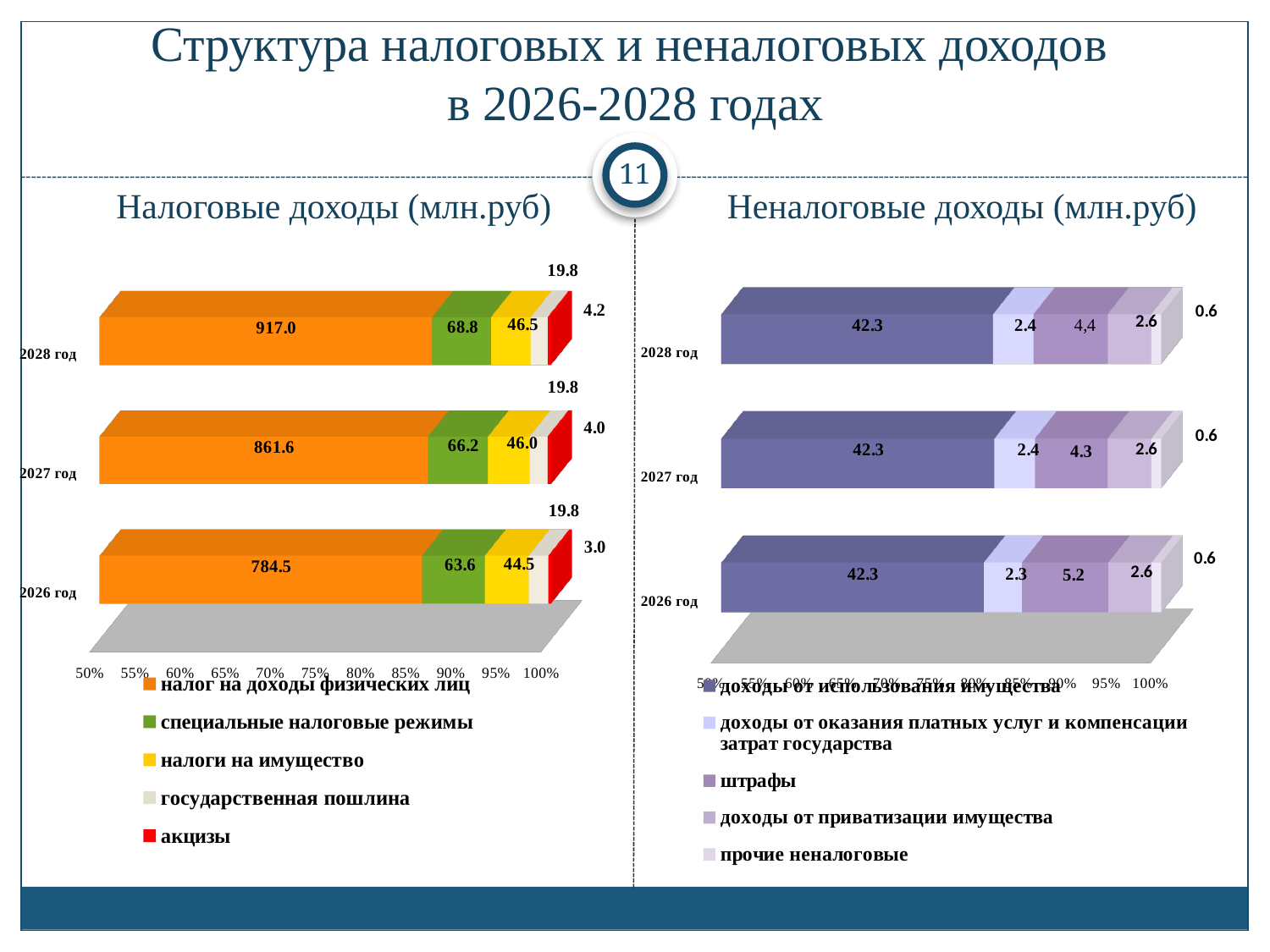
In the chart 'Налоговые доходы (млн.руб)', what is the value of 'налог на доходы физических лиц' for 2028 год? 917.0 In the chart 'Налоговые доходы (млн.руб)', what is the total of the stacked bar for 2026 год? 915.4 What kind of chart is 'Неналоговые доходы (млн.руб)'? Stacked bar chart In the chart 'Неналоговые доходы (млн.руб)', what is the value of 'доходы от использования имущества' for 2027 год? 42.3 In the chart 'Налоговые доходы (млн.руб)', what is the value of 'специальные налоговые режимы' for 2026 год? 63.6 In the chart 'Неналоговые доходы (млн.руб)', what is the value of 'штрафы' for 2026 год? 5.2 How many years (categories) are shown in the chart 'Неналоговые доходы (млн.руб)'? 3 In the chart 'Налоговые доходы (млн.руб)', which year has the highest value for 'налог на доходы физических лиц'? 2028 год In the chart 'Налоговые доходы (млн.руб)', what is the difference between the 'налог на доходы физических лиц' values for 2028 год and 2026 год? 132.5 In the chart 'Неналоговые доходы (млн.руб)', what is the difference between the 'штрафы' values for 2026 год and 2027 год? 0.9 In the chart 'Налоговые доходы (млн.руб)', which is larger: 'акцизы' for 2028 год or 'акцизы' for 2026 год? 2028 год How many series does the legend of the chart 'Налоговые доходы (млн.руб)' list? 5